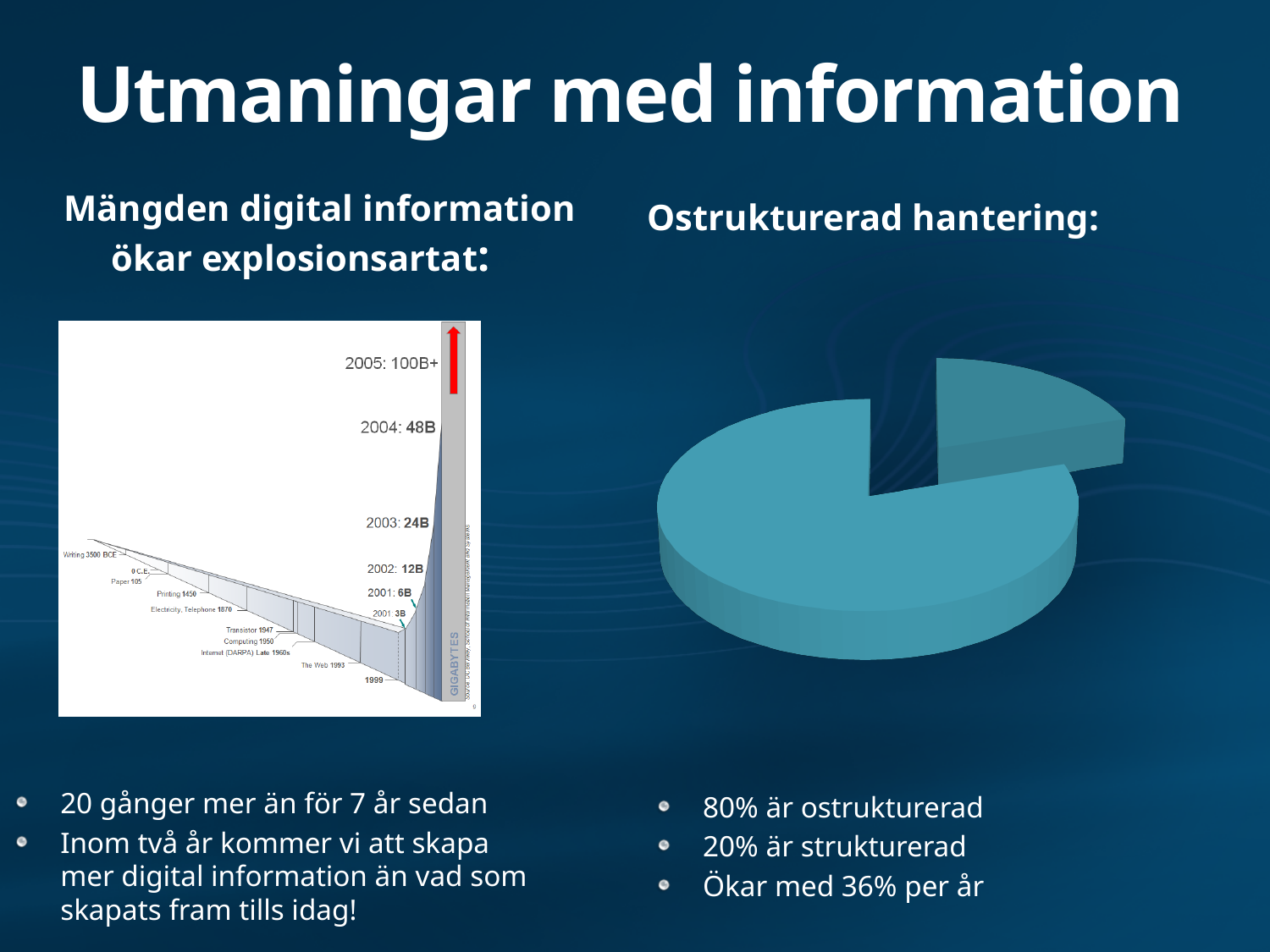
On the left chart, what is the difference between the 2004 value and the 2003 value? 24B What kind of chart is shown on the right under 'Ostrukturerad hantering:'? pie chart On the left chart, what unit is written on the vertical axis? GIGABYTES On the left chart, what value is shown for 2005? 100B+ How many slices does the pie chart on the right have? 2 On the left chart, what value is shown for 2003? 24B On the left chart, which is larger, the value for 2002 or the value for 2003? 2003 On the left chart, do the values rise or fall as time moves toward 2005? rise On the left chart, what value is shown for 2002? 12B On the right pie chart, according to the slide, what share is ostrukturerad (unstructured)? 80% On the left chart (Mängden digital information ökar explosionsartat), what value is shown for 2004? 48B On the right pie chart, according to the slide, what share is strukturerad (structured)? 20%